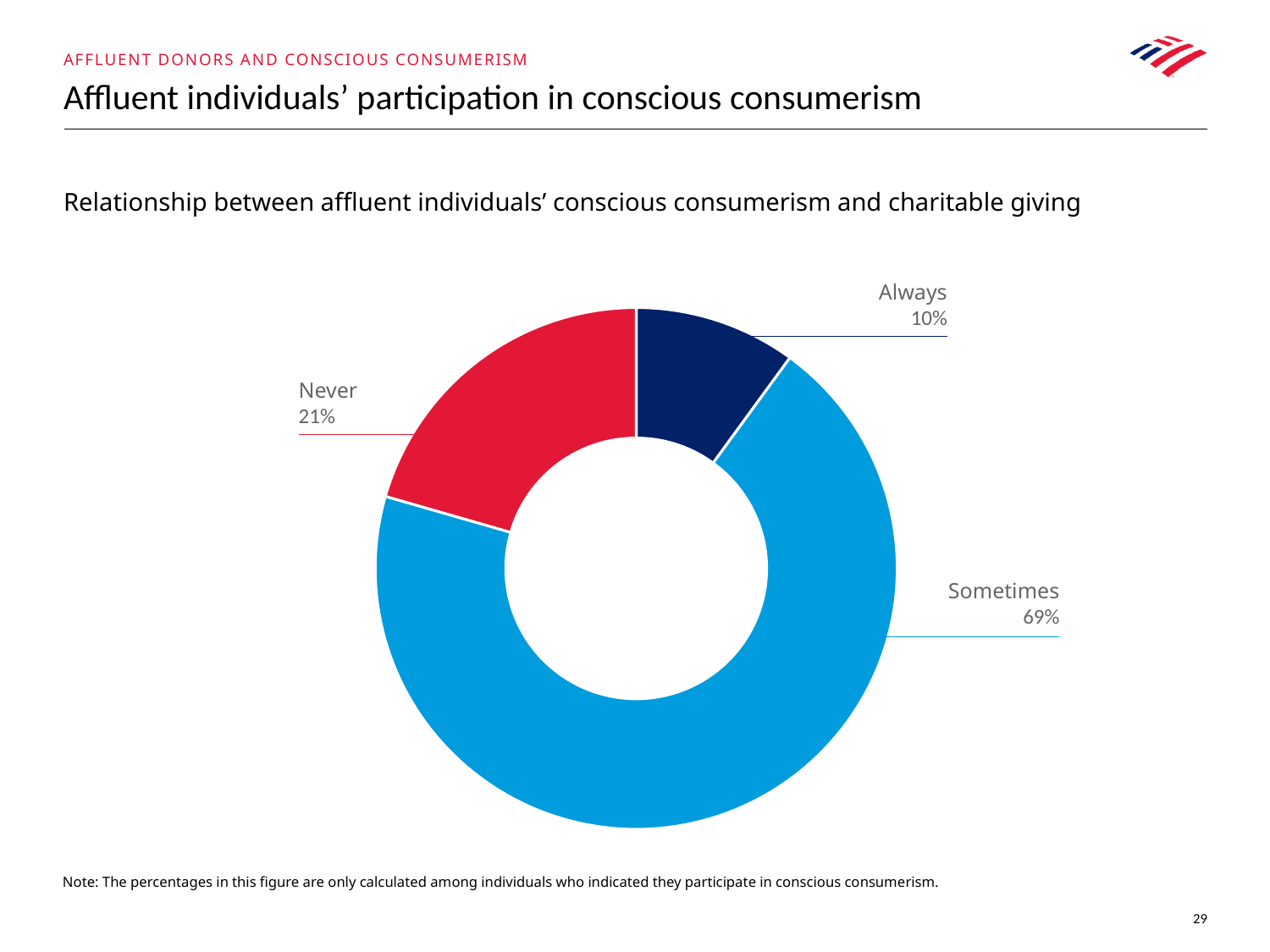
Which category has the smallest share of the chart? Always Which is larger, the share for 'Never' or the share for 'Always'? Never What percentage of affluent individuals answered 'Sometimes'? 69% What is the difference in percentage points between 'Never' and 'Always'? 11 What percentage of affluent individuals answered 'Never'? 21% Which category has the largest share of the chart? Sometimes What kind of chart is shown on the slide? Pie chart (donut) What percentage of affluent individuals answered 'Always'? 10% What colour is the 'Never' segment of the chart? Red How many categories are shown in the chart? 3 What is the difference in percentage points between 'Sometimes' and 'Never'? 48 What is the title of the chart? Relationship between affluent individuals' conscious consumerism and charitable giving